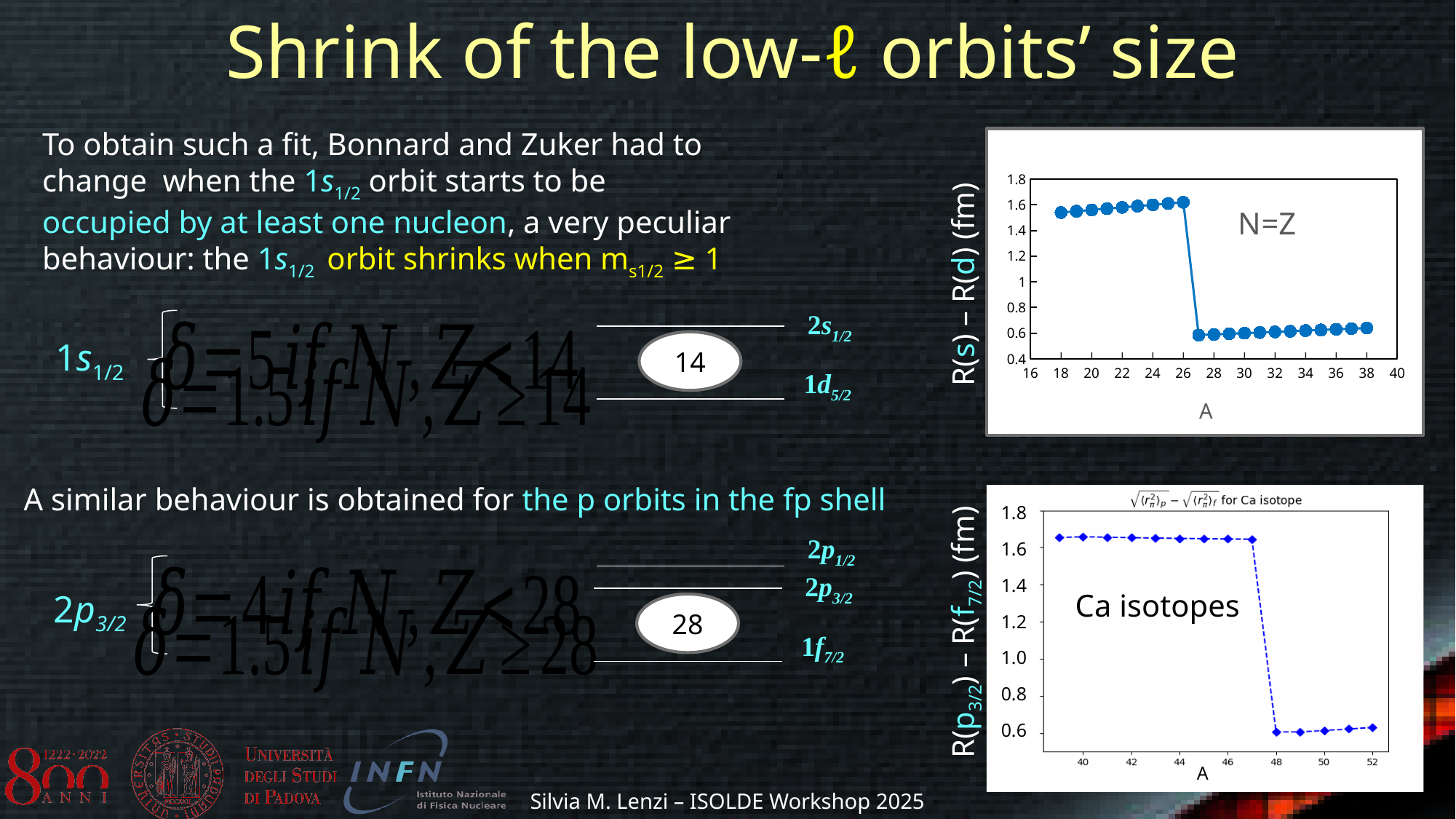
In the bottom-right chart labelled Ca isotopes, which has the larger value, A = 44 or A = 48? A = 44 In the bottom-right chart labelled Ca isotopes, is the value at A = 50 greater or less than 0.8? less What is the x-axis label of the bottom-right chart labelled Ca isotopes? A In the top-right chart labelled N=Z, is the value at A = 30 greater or less than 0.8? less What kind of chart is the bottom-right chart labelled Ca isotopes? line chart In the top-right chart labelled N=Z, is the value at A = 20 greater or less than 1.4? greater In the top-right chart labelled N=Z, do the values overall rise or fall as A increases? fall In the bottom-right chart labelled Ca isotopes, do the values overall rise or fall as A increases? fall What is the y-axis label of the top-right chart labelled N=Z? R(s) – R(d) (fm) In the top-right chart labelled N=Z, which has the larger value, A = 24 or A = 32? A = 24